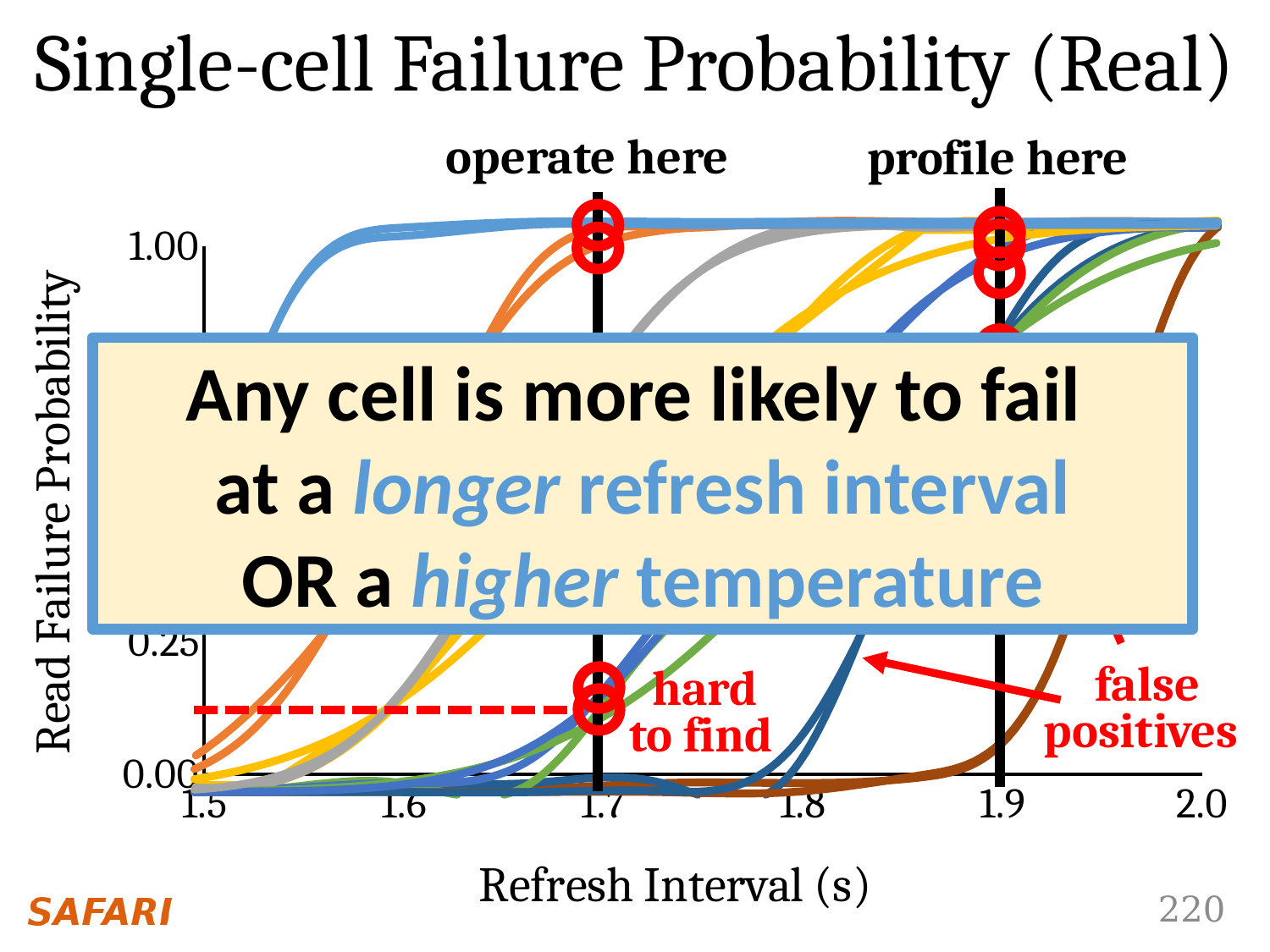
What is the label of the y axis of the chart? Read Failure Probability What is the largest refresh interval shown on the x axis? 2.0 What is the highest value shown on the y axis? 1.00 At which refresh interval is the vertical line labelled "profile here" drawn? 1.9 Is the refresh interval marked "profile here" greater or less than the one marked "operate here"? greater What kind of chart is shown on the slide? line chart What is the smallest refresh interval shown on the x axis? 1.5 What is the label of the x axis of the chart? Refresh Interval (s) Do the curves rise or fall as the refresh interval increases along the x axis? rise What is the title of the chart on the slide? Single-cell Failure Probability (Real) At which refresh interval is the vertical line labelled "operate here" drawn? 1.7